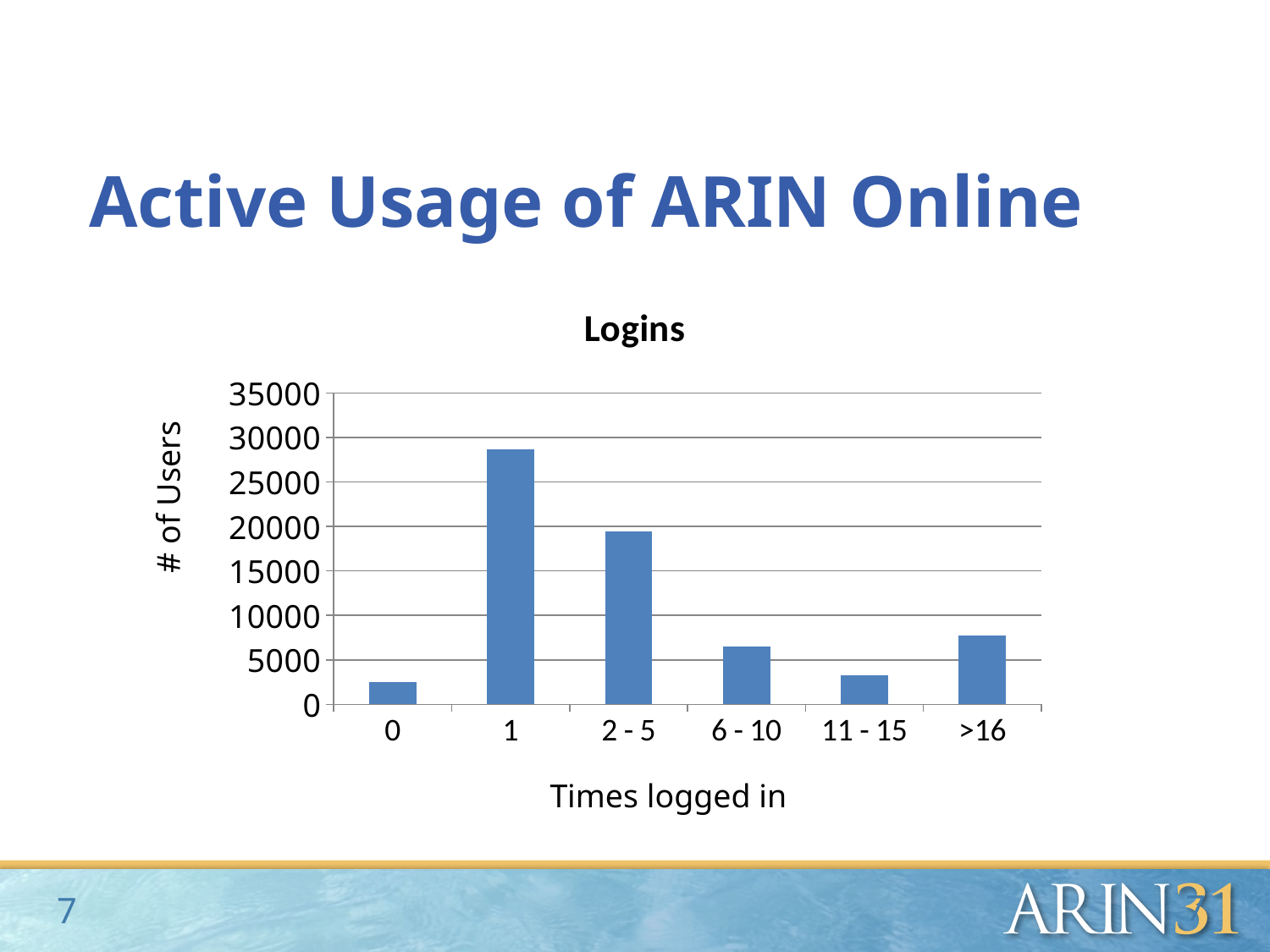
Is the value for the category 1 greater or less than 25000? greater What is the title of the chart? Logins Is the value for the category 0 greater or less than 5000? less What is the label of the x axis? Times logged in Is the value for the category 6 - 10 greater or less than 5000? greater Which has more users, the category 1 or the category 2 - 5? 1 How many categories are shown on the x axis of the chart? 6 What kind of chart is shown on the slide? bar chart Which has more users, the category 6 - 10 or the category >16? >16 Which category has the highest number of users? 1